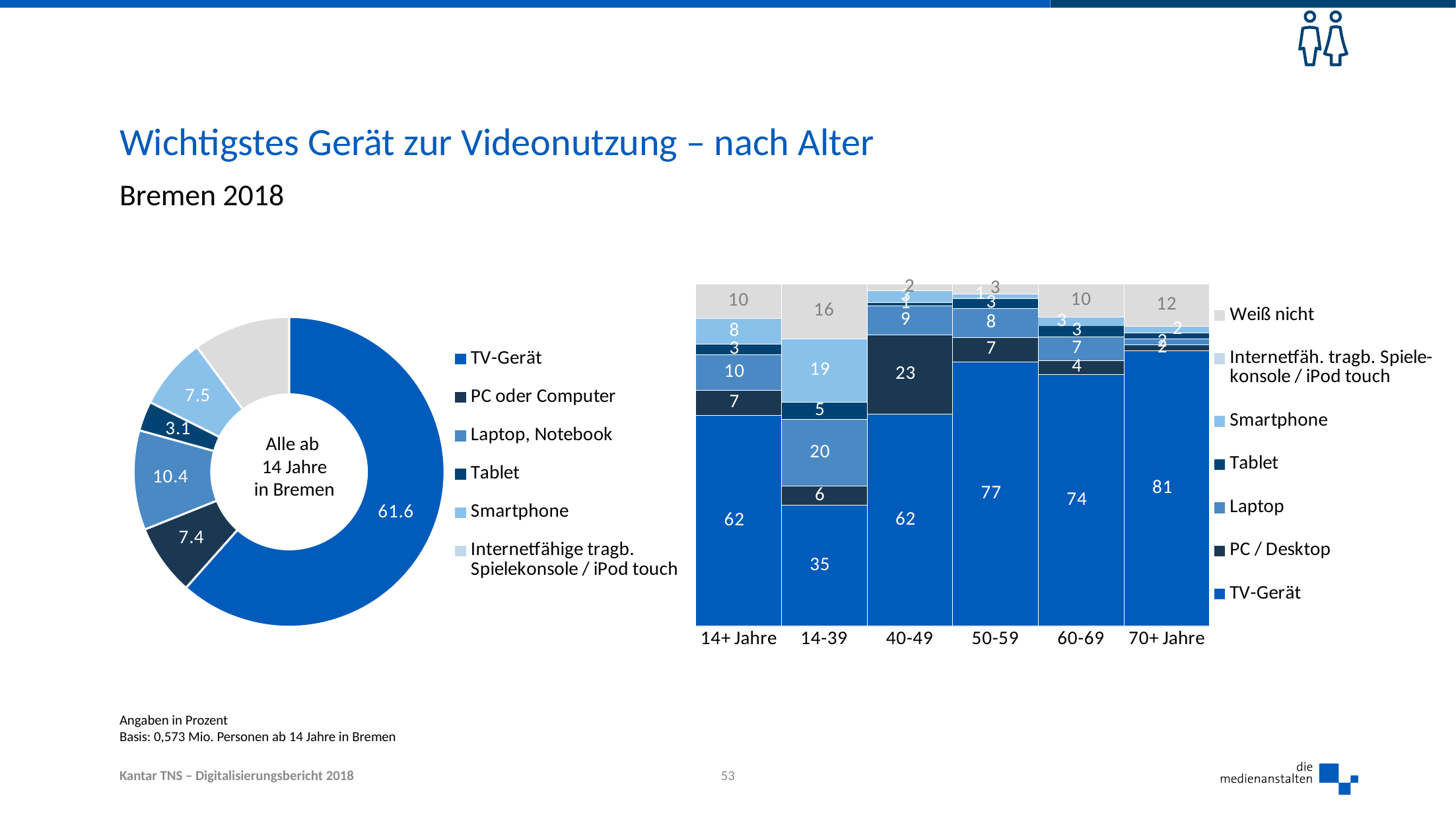
In the stacked bar chart on the right, how many age-group categories are shown on the x axis? 6 In the stacked bar chart on the right, what is the TV-Gerät value for the 14-39 age group? 35 What kind of chart is the chart on the right of the slide? stacked bar chart In the donut chart on the left, what is the value for TV-Gerät? 61.6 In the donut chart on the left, what is the difference between the Smartphone value and the PC oder Computer value? 0.1 In the donut chart on the left, what is the value for Laptop, Notebook? 10.4 In the stacked bar chart on the right, which age group has the highest TV-Gerät value? 70+ Jahre In the stacked bar chart on the right, which age group has the lowest TV-Gerät value? 14-39 In the stacked bar chart on the right, what is the PC / Desktop value for the 40-49 age group? 23 What kind of chart is the chart on the left of the slide? donut (pie) chart In the donut chart on the left, which device has the largest share? TV-Gerät In the stacked bar chart on the right, how many series does the legend list? 7